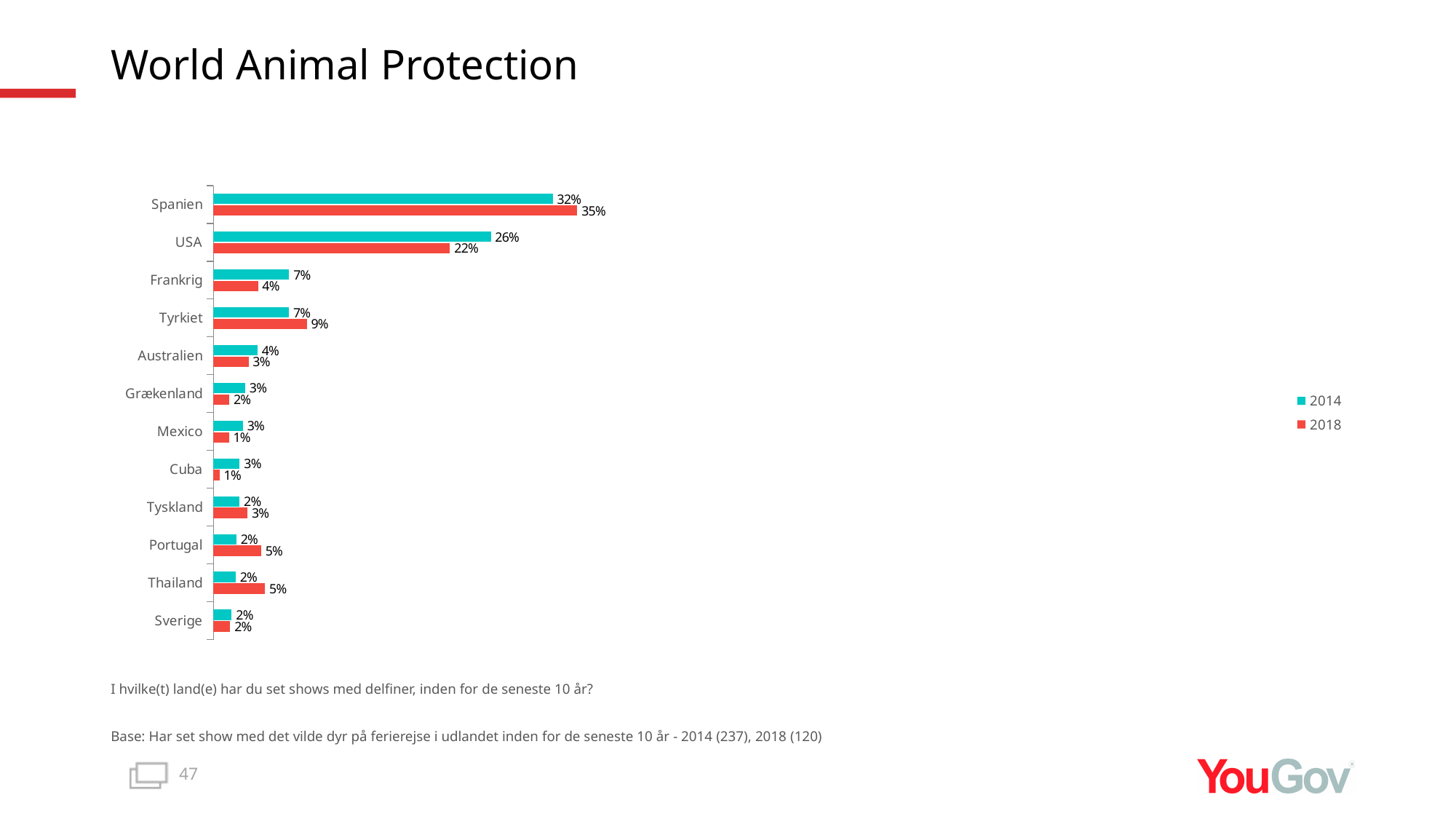
What is the 2014 value for USA? 26% What is the difference between the 2014 and 2018 values for USA? 4% Which country has the lowest 2018 value? Mexico and Cuba (1%) How many series does the legend list? 2 What kind of chart is shown on the slide? Bar chart What is the difference between the 2018 and 2014 values for Thailand? 3% Which colour represents the 2018 series in the legend? Red How many countries are shown on the chart? 12 Which country has the highest 2014 value? Spanien What is the 2018 value for Spanien? 35% What is the 2018 value for Tyrkiet? 9% Which is larger for Portugal: the 2014 value or the 2018 value? 2018